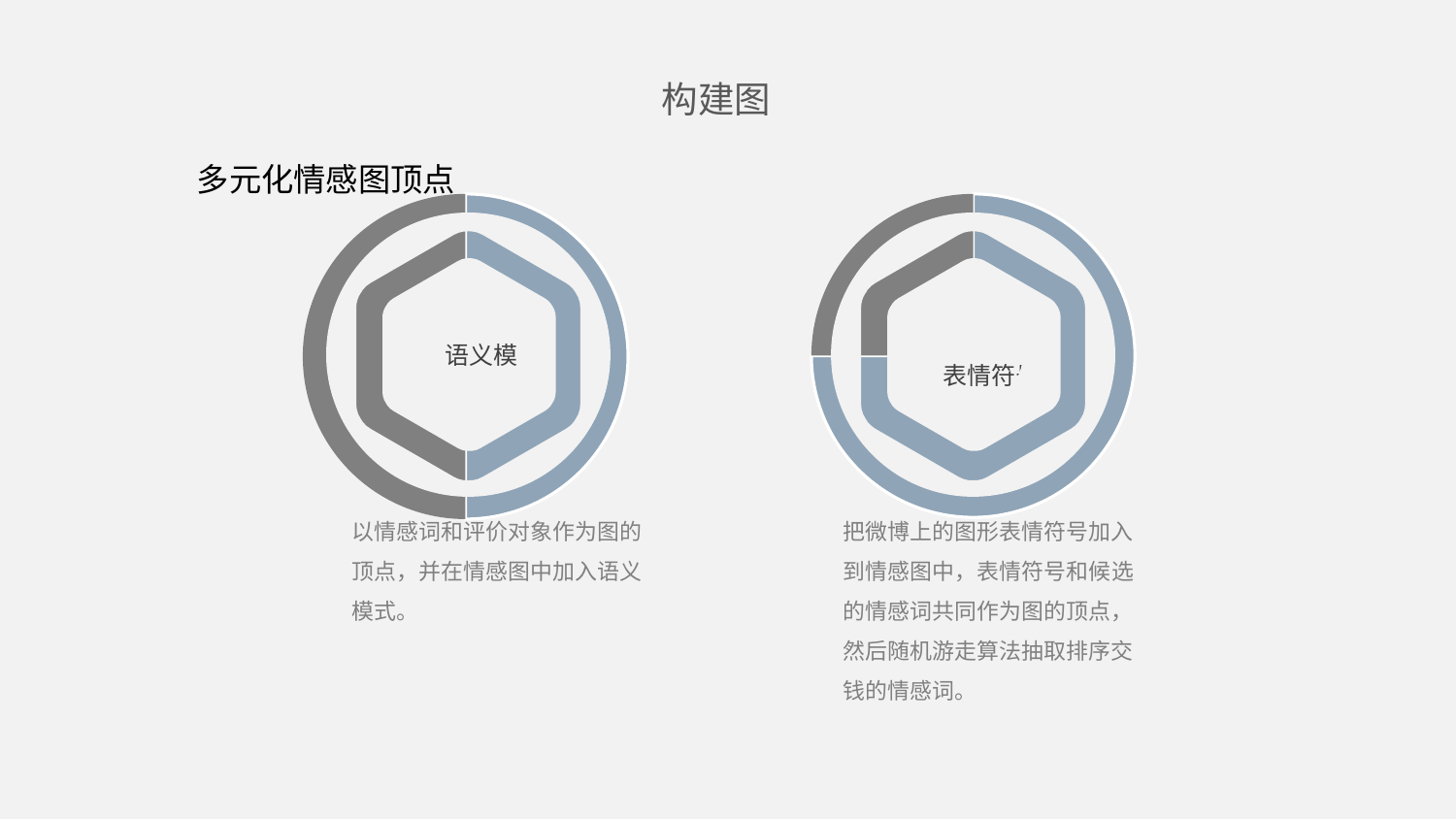
In the right chart (labelled 表情符), is the blue segment's share of the ring greater or less than 50%? greater How many segments does the left chart (labelled 语义模) have? 2 In the right chart (labelled 表情符), which segment is larger, the blue one or the grey one? the blue one In the right chart (labelled 表情符), is the grey segment's share of the ring greater or less than 50%? less How many segments does the right chart (labelled 表情符) have? 2 What two colours are used for the segments of the left chart (labelled 语义模)? grey and blue What kind of chart is the right chart (labelled 表情符)? doughnut chart What text is shown in the centre of the left chart? 语义模 What kind of chart is the left chart (labelled 语义模)? doughnut chart